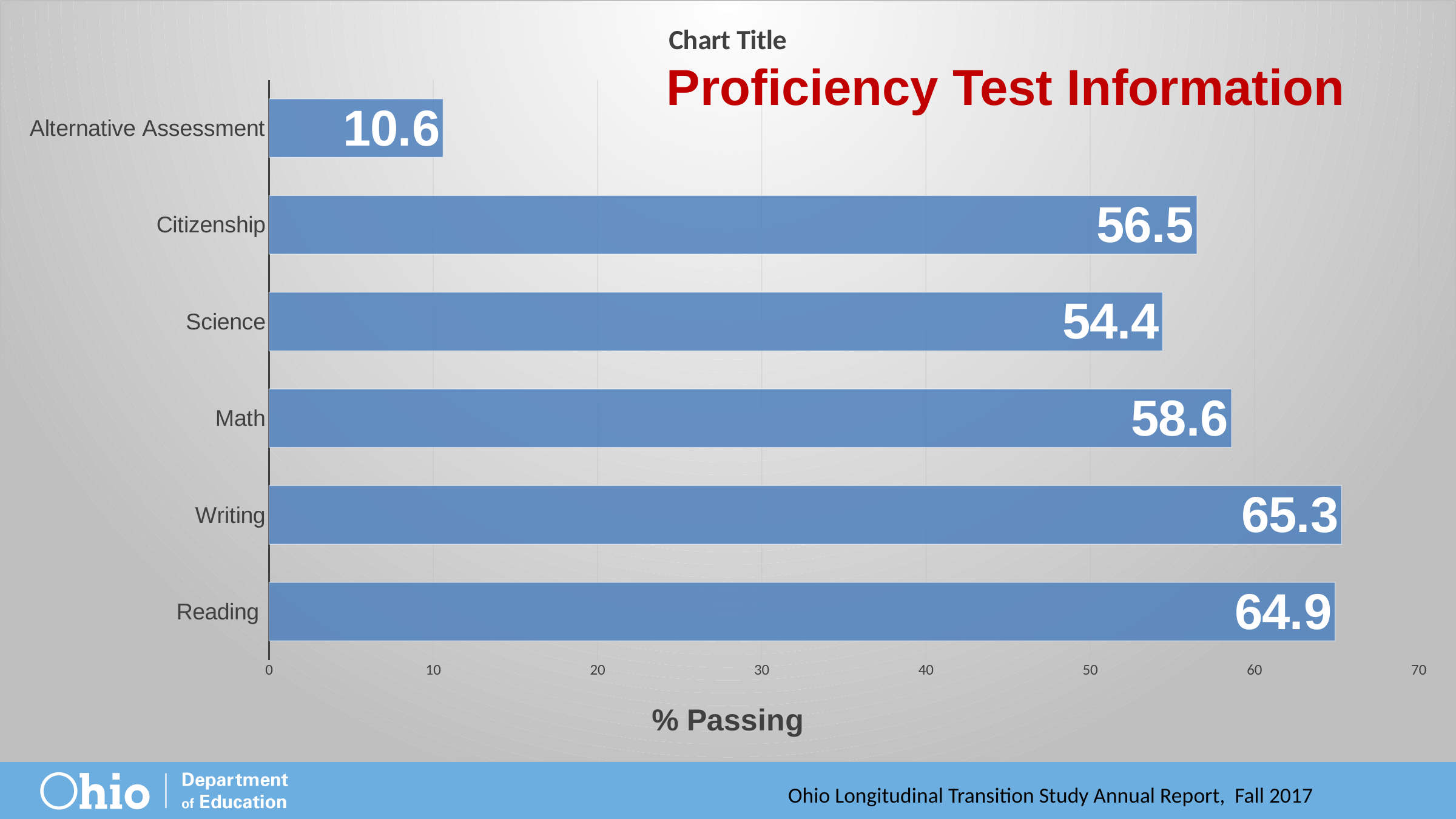
What is the % Passing value for Reading? 64.9 Which category has the highest % Passing? Writing What is the % Passing value for Science? 54.4 How many categories are shown in the chart? 6 Which has a higher % Passing, Citizenship or Science? Citizenship What kind of chart is shown on the slide? bar chart What is the % Passing value for Alternative Assessment? 10.6 What is the difference between the % Passing for Math and Citizenship? 2.1 Which category has the lowest % Passing? Alternative Assessment What is the label on the horizontal axis of the chart? % Passing Is the value for Math greater or less than 50? greater What is the difference between the % Passing for Writing and Reading? 0.4